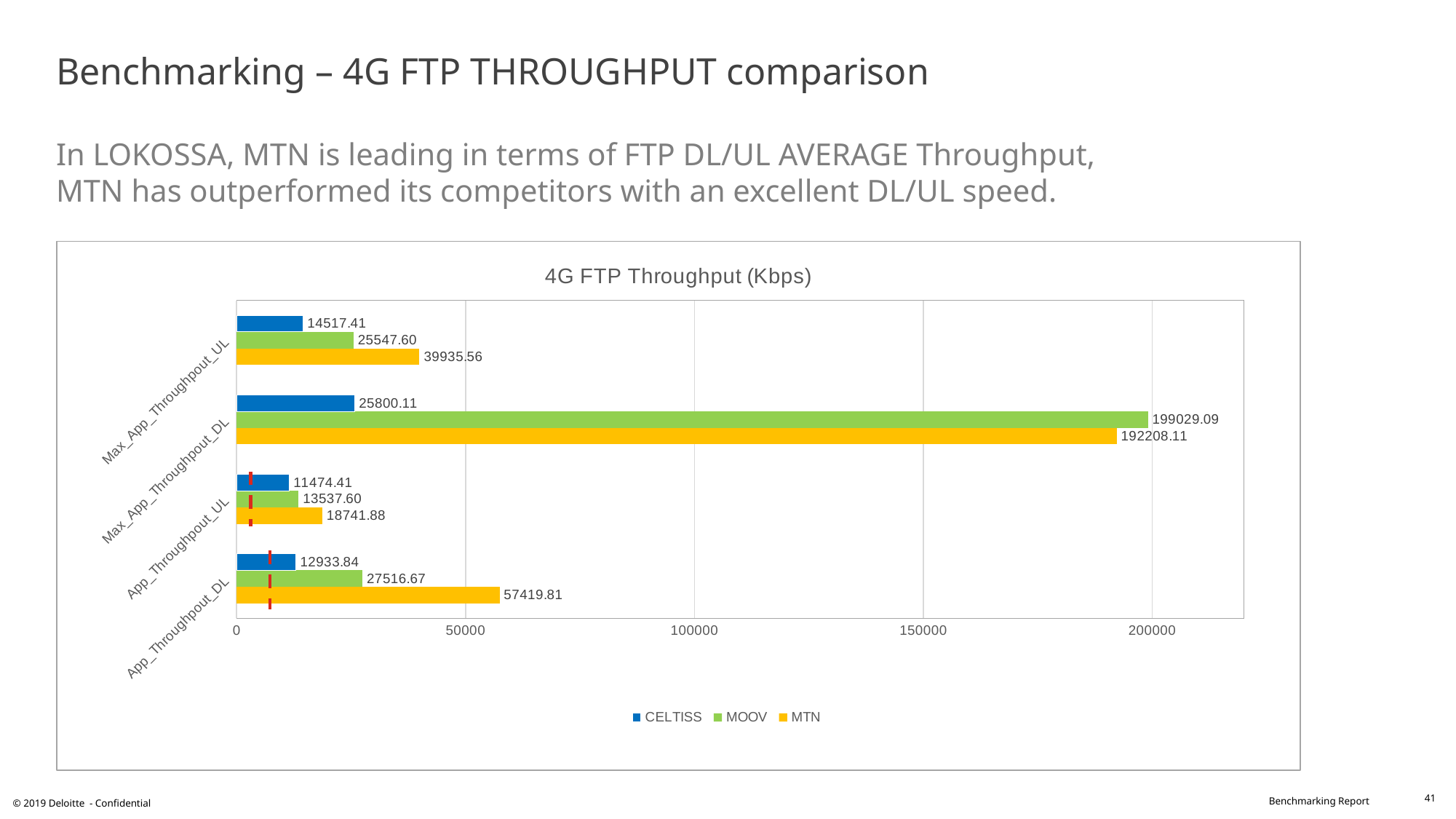
What is the MTN value for Max_App_Throughpout_UL? 39935.56 How many series does the legend list? 3 Is the MTN value for Max_App_Throughpout_DL greater or less than 150000? greater Which operator has the highest value for Max_App_Throughpout_DL? MOOV Which is larger for Max_App_Throughpout_UL: the MOOV value or the CELTISS value? MOOV Which operator has the lowest value for App_Throughpout_DL? CELTISS What type of chart is shown on the slide? Bar chart What is the MOOV value for Max_App_Throughpout_DL? 199029.09 What is the title of the chart? 4G FTP Throughput (Kbps) What is the MTN value for App_Throughpout_DL? 57419.81 What is the CELTISS value for App_Throughpout_UL? 11474.41 What is the difference between the MTN and MOOV values for App_Throughpout_DL? 29903.14